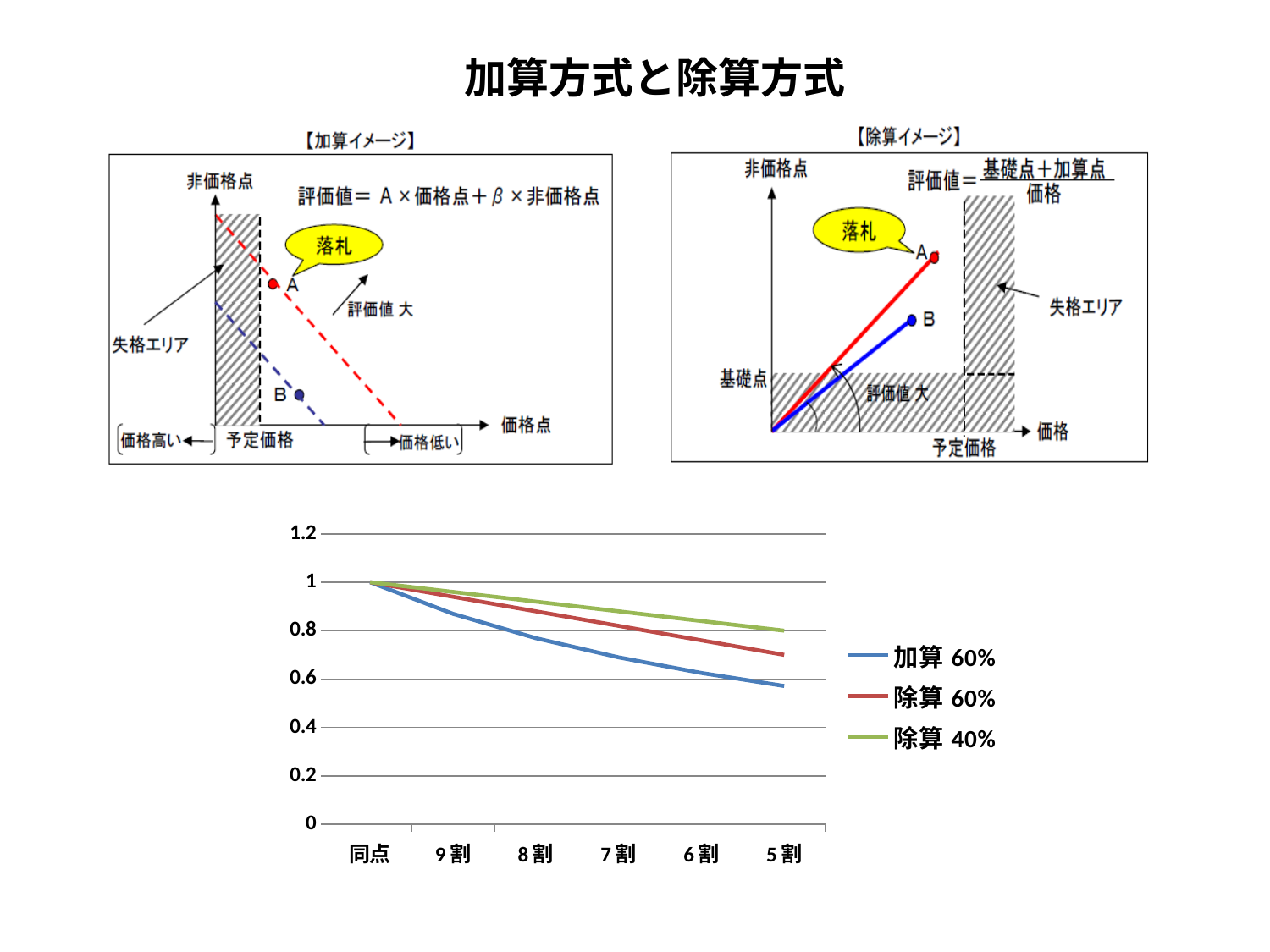
What kind of chart is the chart at the bottom of the slide? line chart In the bottom chart, which series has the lowest value at 5割? 加算 60% In the bottom chart, what is the value of the 除算 40% series at 5割? 0.8 How many series does the legend of the bottom chart list? 3 In the bottom chart, do the values of the 加算 60% series rise or fall from 同点 to 5割? fall In the bottom chart, at 5割, is the value of 加算 60% greater or less than 0.6? less How many categories are on the x axis of the bottom chart? 6 In the bottom chart, what is the value of the 除算 60% series at 同点? 1 In the bottom chart, what colour is the line for the 除算 40% series? green In the bottom chart, at 6割, which is larger: the value of 除算 60% or the value of 加算 60%? 除算 60% In the bottom chart, which series has the highest value at 5割? 除算 40%